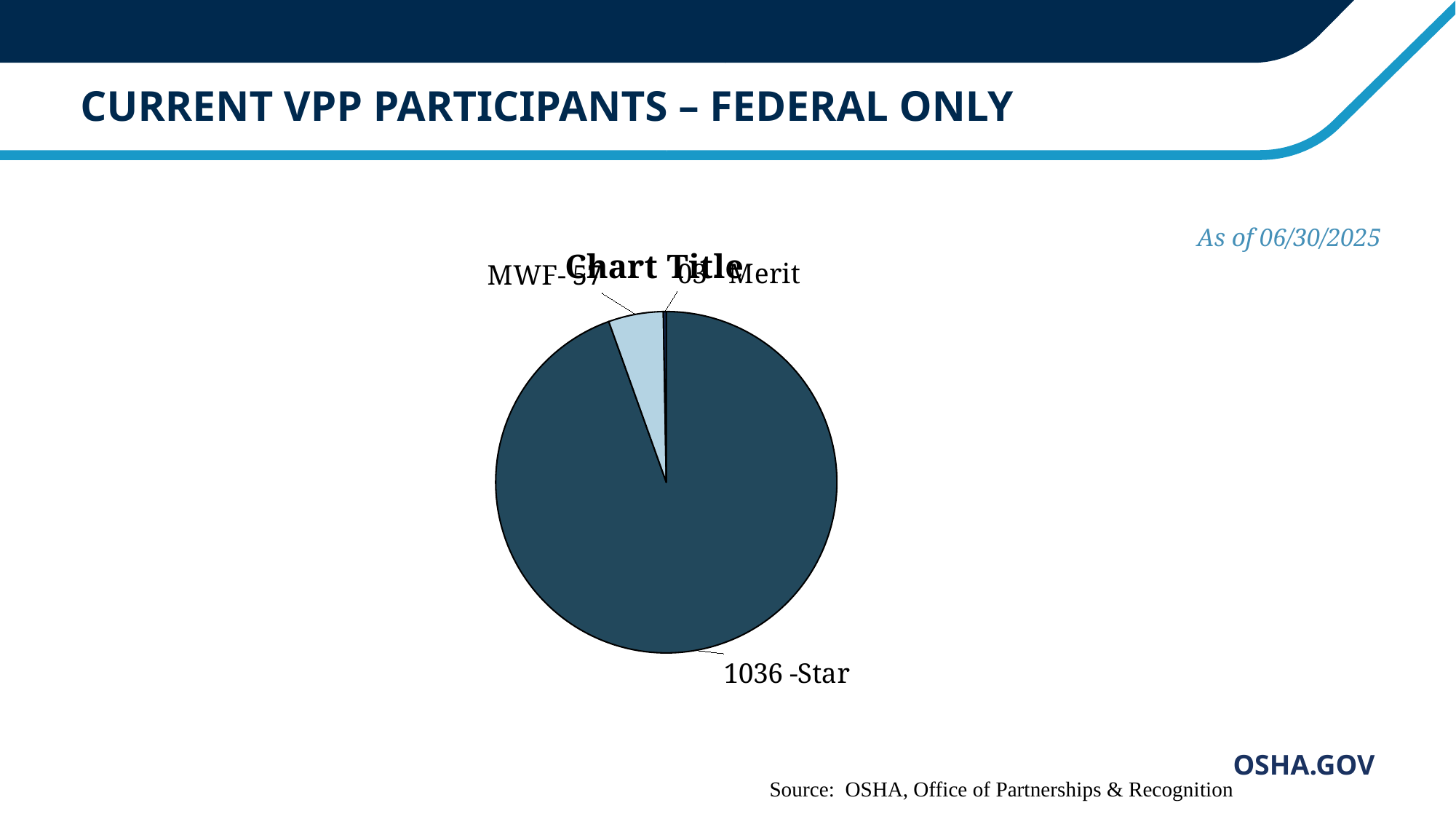
Which slice is larger, Star or MWF? Star What colour is the Star slice of the pie? dark teal What is the value shown for the Star slice? 1036 What is the title printed above the pie chart? Chart Title How many slices does the pie chart have? 3 Which slice is larger, MWF or Merit? MWF What kind of chart is shown on the slide? pie chart Which category has the smallest slice of the pie? Merit Which category has the largest slice of the pie? Star